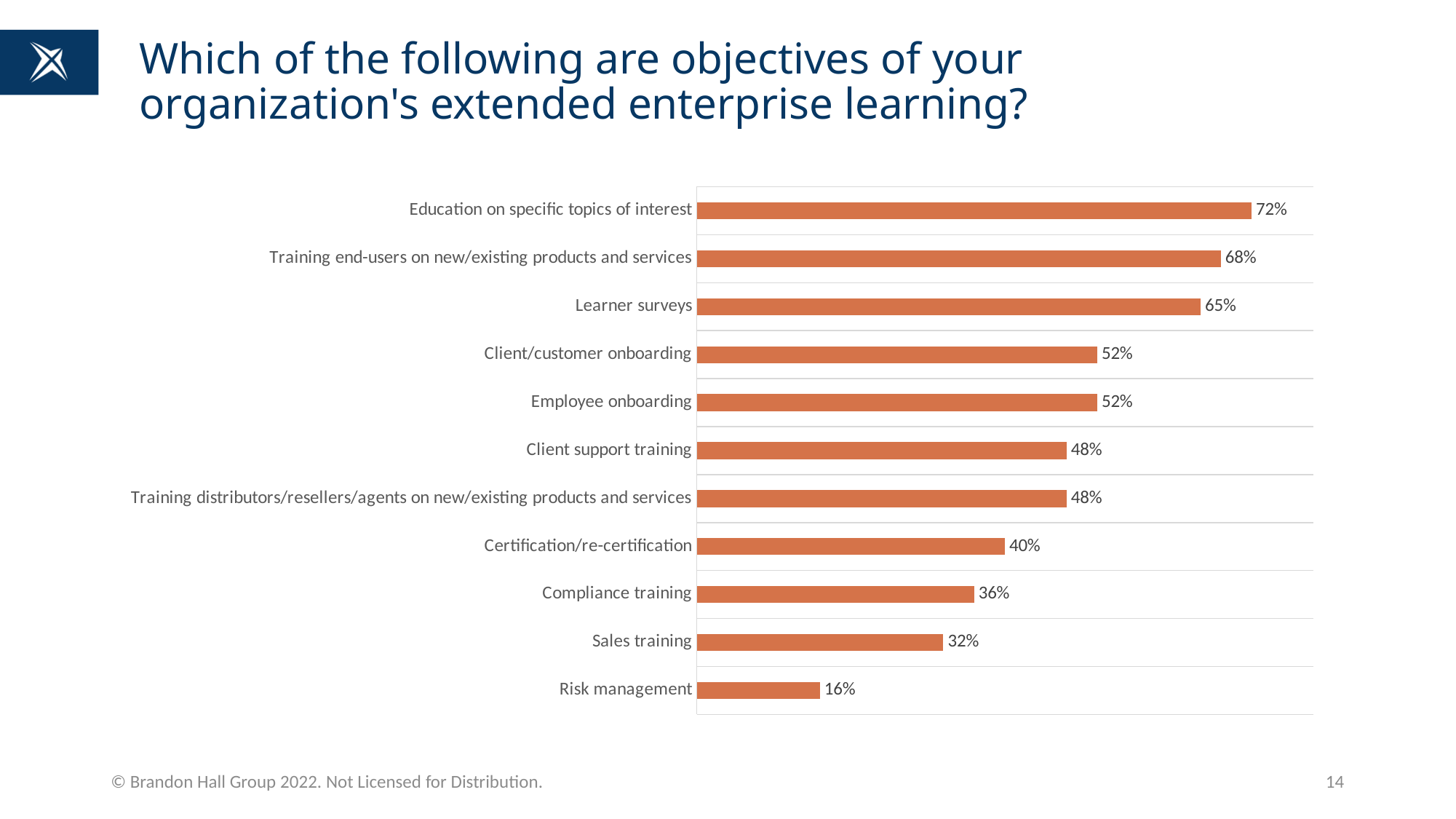
Which objective has the highest percentage? Education on specific topics of interest What is the difference between the values for Sales training and Risk management? 16% How many objectives are listed in the chart? 11 What is the value for Risk management? 16% What is the value for Compliance training? 36% Which is larger, the value for Certification/re-certification or the value for Compliance training? Certification/re-certification What percentage of respondents selected Education on specific topics of interest as an objective? 72% What kind of chart is shown on the slide? Bar chart What is the difference between the values for Education on specific topics of interest and Training end-users on new/existing products and services? 4% What colour are the bars in the chart? Orange What is the value for Learner surveys? 65% Which objective has the lowest percentage? Risk management